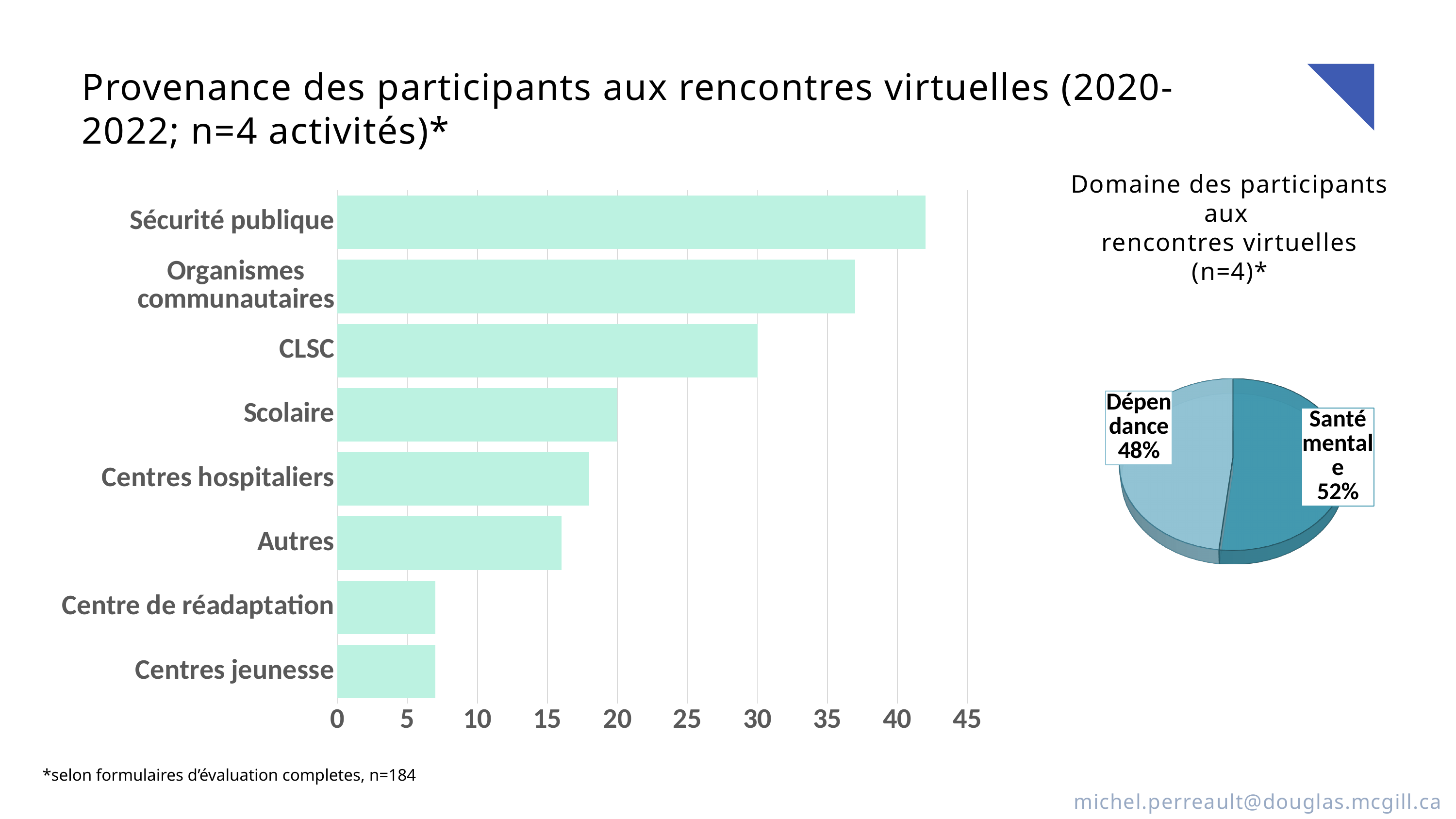
In the bar chart on the left, is the value for Sécurité publique greater or less than 40? greater In the pie chart 'Domaine des participants aux rencontres virtuelles (n=4)*', what is the difference between the Santé mentale and Dépendance shares? 4% In the bar chart on the left, what is the value for CLSC? 30 In the bar chart on the left, which category has the highest value? Sécurité publique How many categories are shown in the bar chart on the left? 8 In the pie chart 'Domaine des participants aux rencontres virtuelles (n=4)*', which slice is larger: Dépendance or Santé mentale? Santé mentale In the bar chart on the left, what is the value for Scolaire? 20 In the bar chart on the left, is the value for Centre de réadaptation greater or less than 5? greater What kind of chart is the chart on the left of the slide? bar chart In the pie chart 'Domaine des participants aux rencontres virtuelles (n=4)*', what share is Santé mentale? 52% In the bar chart on the left, is the value for Centres hospitaliers greater or less than 20? less In the bar chart on the left, which is larger: Organismes communautaires or Autres? Organismes communautaires